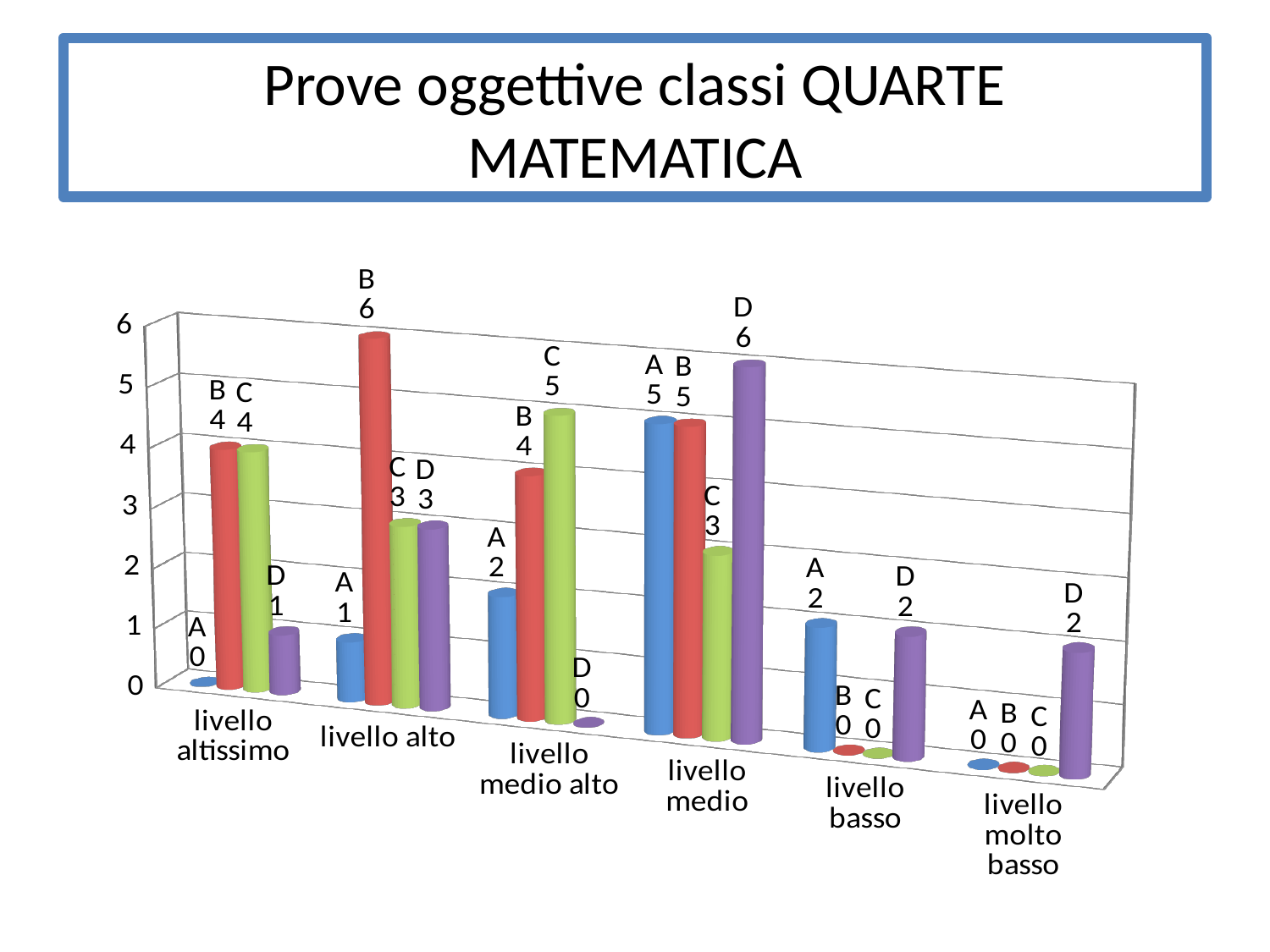
What is the value for series C in the 'livello medio alto' category? 5 Which series has the lowest value in the 'livello alto' category? A Which series has the highest value in the 'livello medio' category? D What is the value for series A in the 'livello altissimo' category? 0 How many categories are shown on the x axis? 6 What is the total of the values for series A, B, C and D in the 'livello basso' category? 4 What kind of chart is shown on the slide? bar chart Which is larger in the 'livello medio alto' category: the value for series B or series C? C What is the title of the slide containing the chart? Prove oggettive classi QUARTE MATEMATICA What is the difference between the values for series B and series A in the 'livello alto' category? 5 What is the value for series B in the 'livello alto' category? 6 What is the value for series D in the 'livello medio' category? 6